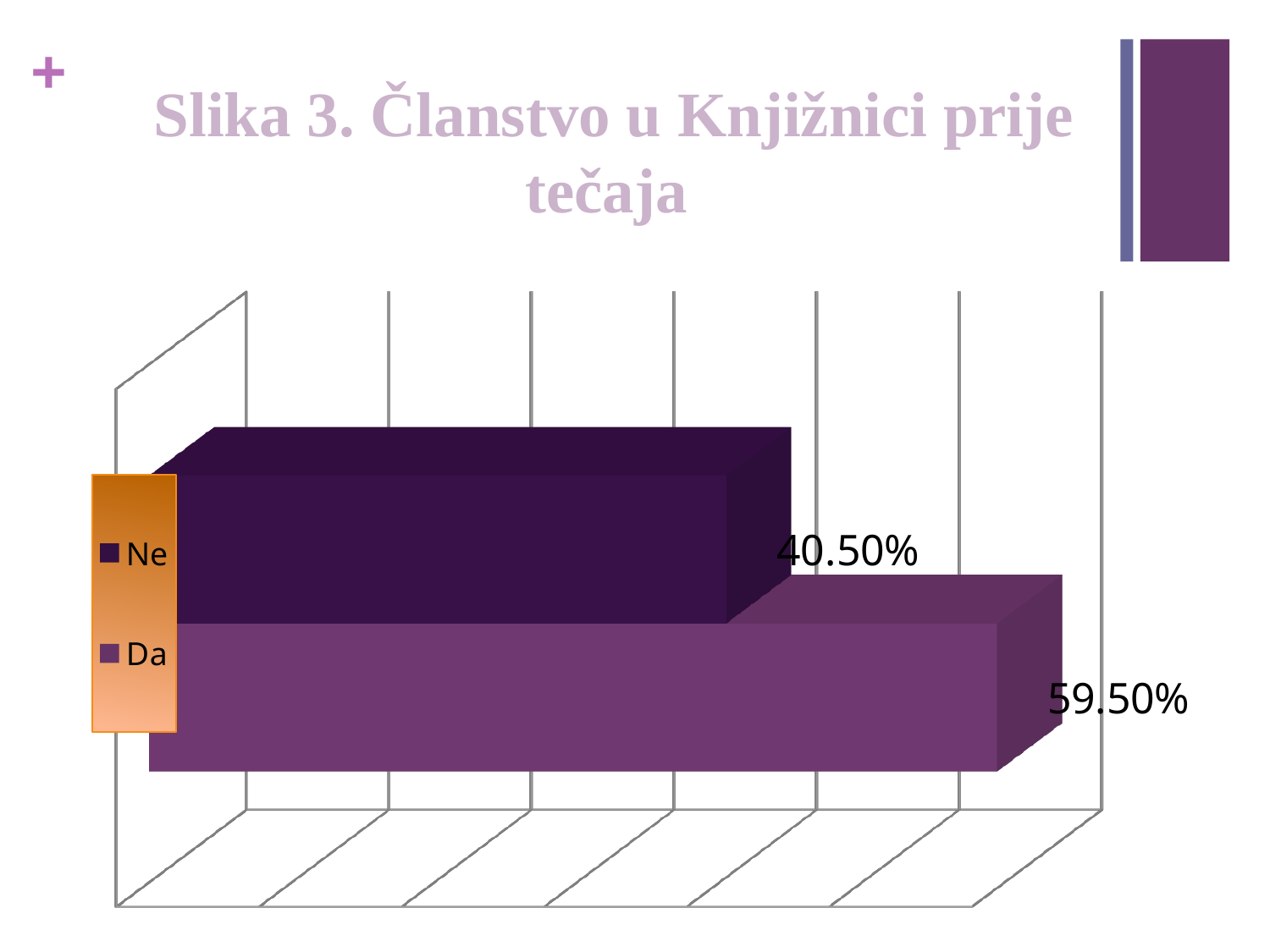
Which category has the highest value? Da What is the title of the chart on the slide? Slika 3. Članstvo u Knjižnici prije tečaja What is the value shown for "Ne"? 40.50% What are the two entries listed in the legend? Ne and Da What is the value shown for "Da"? 59.50% What kind of chart is shown on the slide? Bar chart Which category has the lowest value? Ne Which is larger, the value for "Da" or the value for "Ne"? Da How many bars are plotted in the chart? 2 What is the difference between the values for "Da" and "Ne"? 19.00% How many entries does the legend list? 2